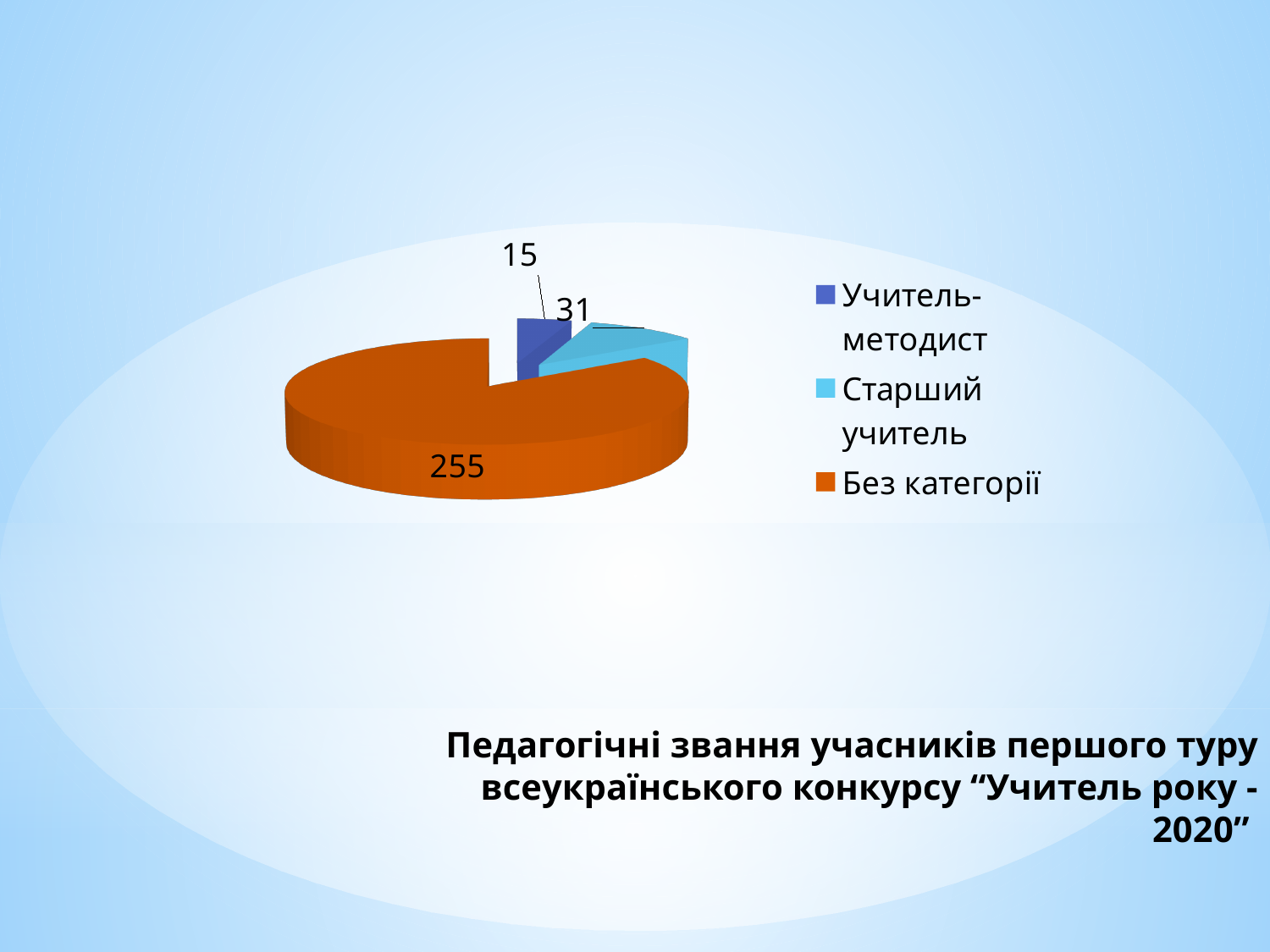
What is the difference between the values for Без категорії and Старший учитель? 224 What is the value for Учитель-методист? 15 What is the value for Старший учитель? 31 What colour is the slice for Без категорії? Orange What type of chart is shown on the slide? Pie chart What is the value for Без категорії? 255 Which category has the largest slice of the pie? Без категорії How many categories does the pie chart have? 3 Which category has the smallest slice of the pie? Учитель-методист What is the difference between the values for Старший учитель and Учитель-методист? 16 Which is larger, the value for Старший учитель or the value for Учитель-методист? Старший учитель What is the total of all slices in the pie chart? 301